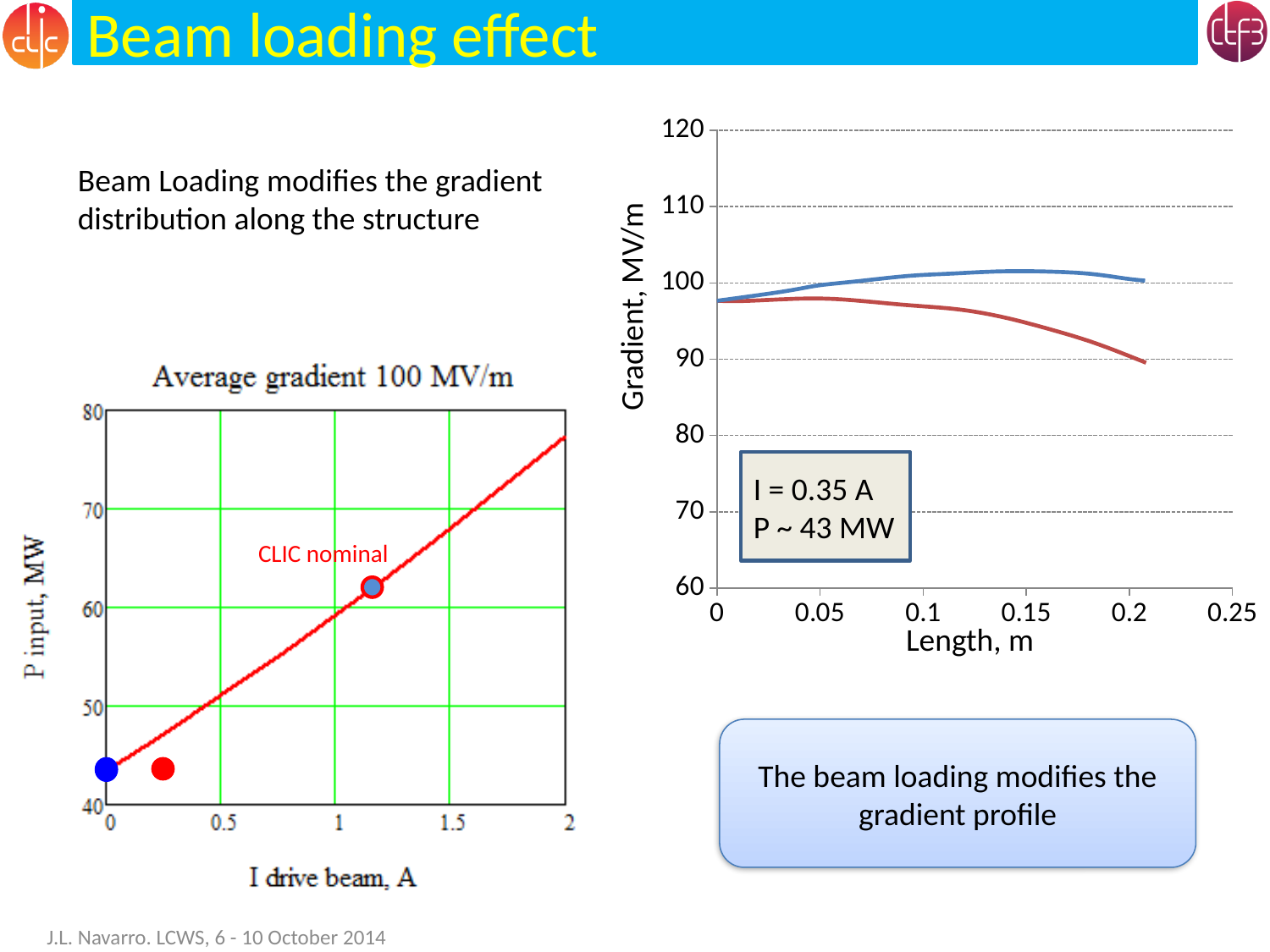
In the left chart titled "Average gradient 100 MV/m", what is the label of the annotated point on the red line? CLIC nominal In the left chart titled "Average gradient 100 MV/m", what is the label of the x axis? I drive beam, A In the right chart (Gradient vs Length), does the red curve rise or fall overall as Length increases? falls In the right chart (Gradient vs Length), how many curves are plotted? 2 In the right chart (Gradient vs Length), is the red curve's gradient at Length 0.15 m greater or less than 100? less In the left chart titled "Average gradient 100 MV/m", is the P input value at the point labelled "CLIC nominal" greater or less than 60? greater In the left chart titled "Average gradient 100 MV/m", is the P input value of the blue dot at I drive beam = 0 greater or less than 50? less What kind of chart is the left chart titled "Average gradient 100 MV/m"? line chart In the right chart (Gradient vs Length), what is the maximum value shown on the y axis? 120 In the left chart titled "Average gradient 100 MV/m", does P input rise or fall as I drive beam increases? rises In the right chart (Gradient vs Length), at Length 0.15 m, which curve has the higher gradient, the blue or the red? blue